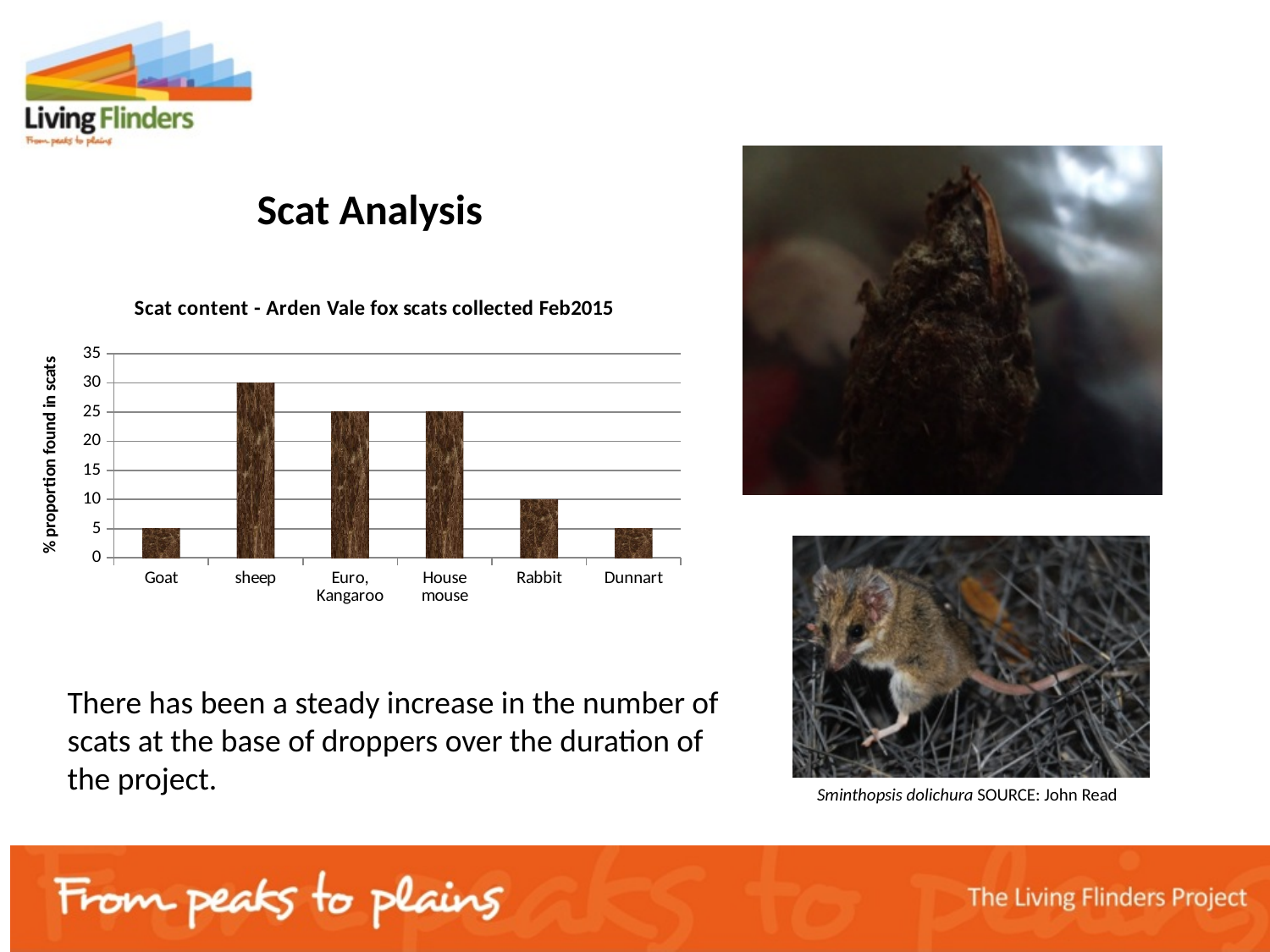
Which category has the highest value in the Scat content chart? sheep What is the value for House mouse in the Scat content chart? 25 What is the difference between the values for sheep and Rabbit in the Scat content chart? 20 What is the value for Rabbit in the Scat content chart? 10 What is the label of the vertical axis in the Scat content chart? % proportion found in scats What is the value for sheep in the Scat content chart? 30 How many categories are shown in the Scat content chart? 6 Is the value for Rabbit in the Scat content chart greater or less than 15? less What kind of chart is the Scat content chart? bar chart What is the title of the chart on the slide? Scat content - Arden Vale fox scats collected Feb2015 What is the value for Goat in the Scat content chart? 5 Which is larger in the Scat content chart, the value for Euro, Kangaroo or the value for Dunnart? Euro, Kangaroo